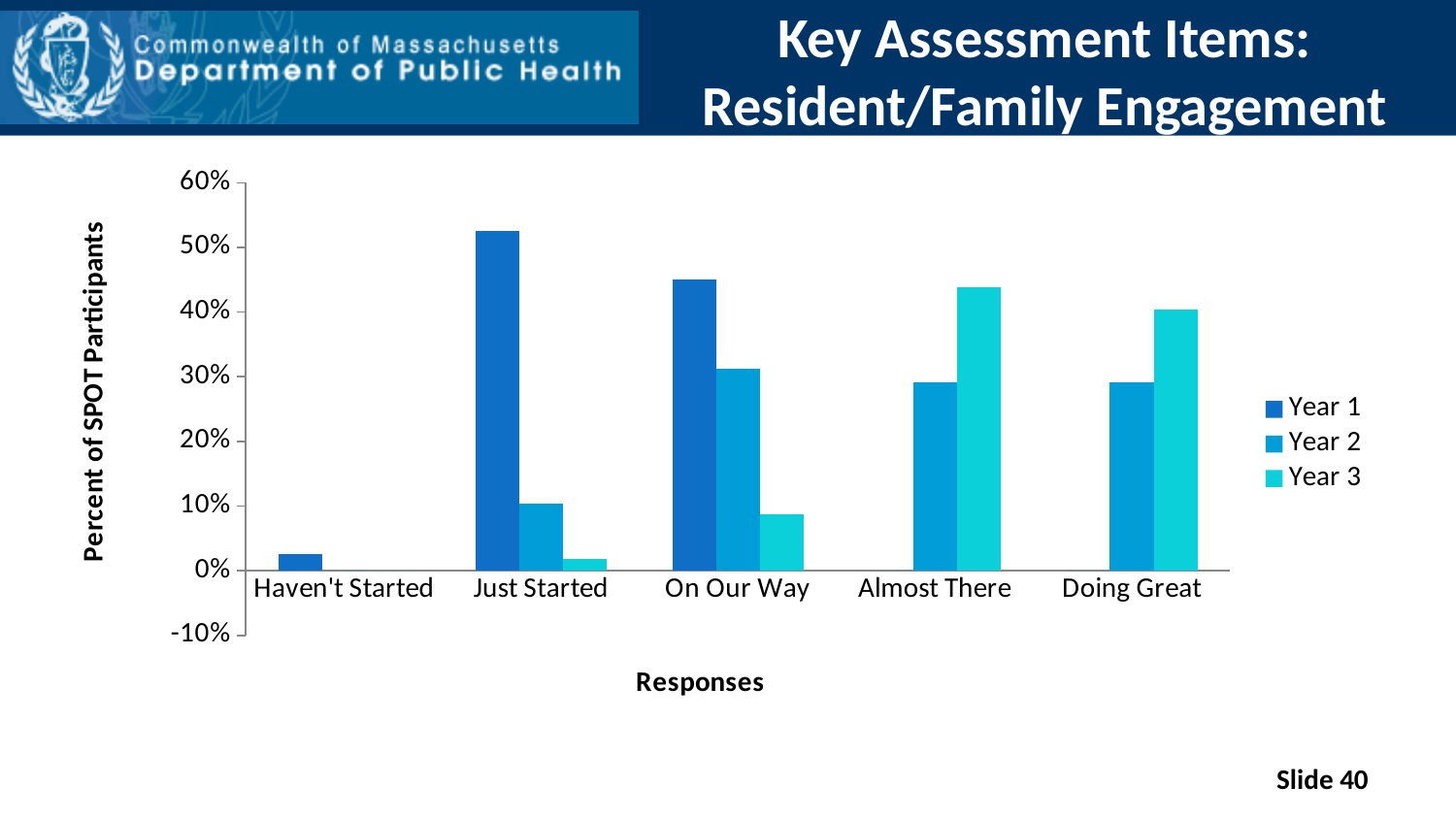
For On Our Way, which is larger: the Year 1 value or the Year 2 value? Year 1 What kind of chart is shown on the slide? Bar chart Which response category has the highest Year 3 value? Almost There Is the Year 3 value for Just Started greater or less than 10%? less Is the Year 3 value for Doing Great greater or less than 30%? greater Which response category has the highest Year 1 value? Just Started Is the Year 1 value for Just Started greater or less than 50%? greater Do the Year 1 values rise or fall from Just Started to Doing Great? fall For Almost There, which is larger: the Year 2 value or the Year 3 value? Year 3 What is the title of the y axis? Percent of SPOT Participants How many series does the legend list? 3 How many response categories are shown on the x axis? 5